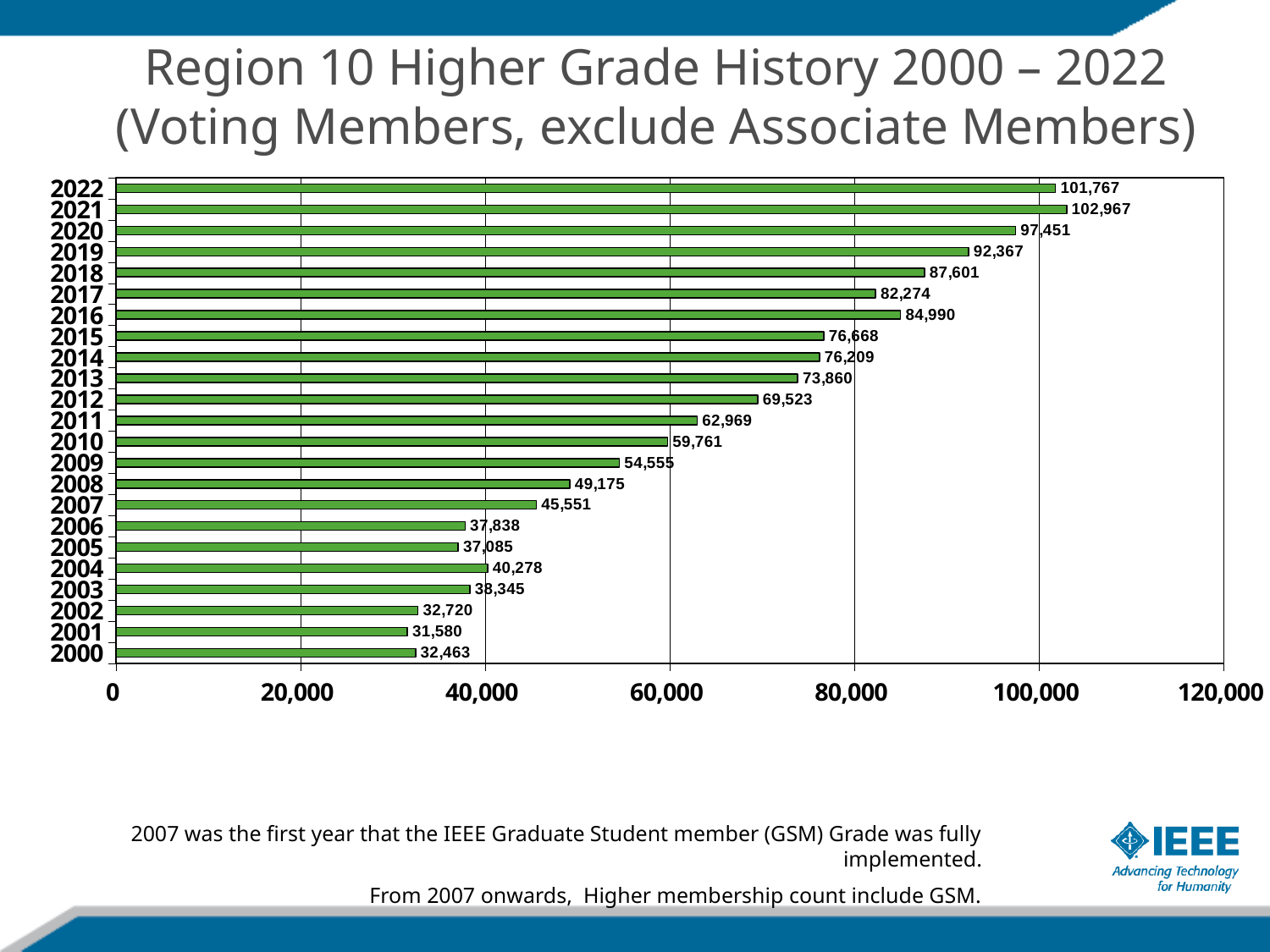
How many years are shown in the chart? 23 What kind of chart is shown on the slide? bar chart What is the value for 2007? 45,551 Do the values generally rise or fall from 2000 to 2022? rise What is the value for 2022? 101,767 Is the value for 2018 greater or less than 80,000? greater What is the value for 2000? 32,463 What is the difference between the values for 2021 and 2022? 1,200 What is the difference between the values for 2020 and 2019? 5,084 Which is larger, the value for 2016 or the value for 2017? 2016 Which year has the highest value? 2021 Which year has the lowest value? 2001